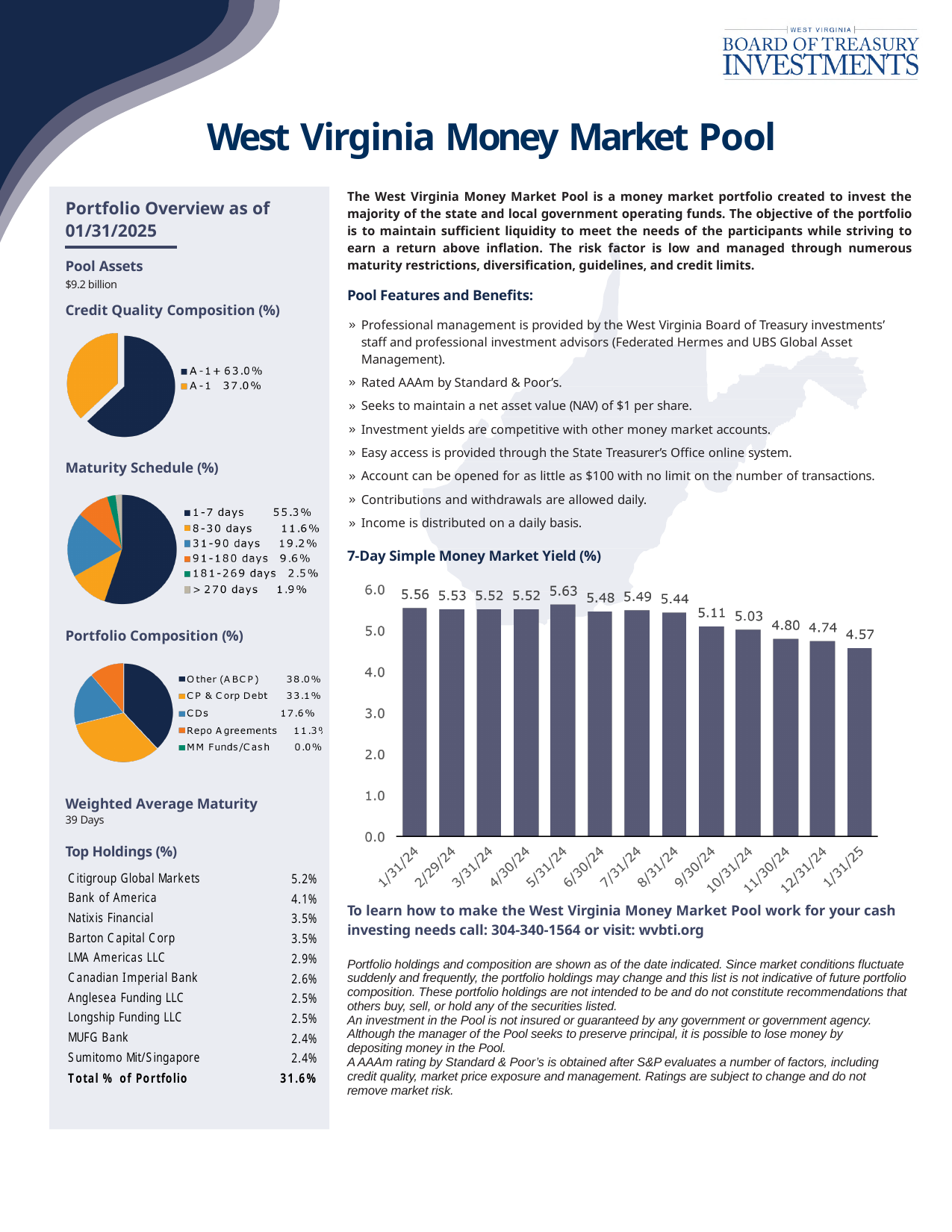
How many categories does the legend of the Portfolio Composition pie chart list? 5 In the Portfolio Composition pie chart, which is larger, CDs or Repo Agreements? CDs In the 7-Day Simple Money Market Yield chart, which date has the highest yield? 5/31/24 In the 7-Day Simple Money Market Yield chart, do the values generally rise or fall from 1/31/24 to 1/31/25? fall In the Maturity Schedule pie chart, what is the value for 31-90 days? 19.2% In the Maturity Schedule pie chart, which category has the largest share? 1-7 days In the 7-Day Simple Money Market Yield chart, how many dates are plotted? 13 In the 7-Day Simple Money Market Yield chart, which date has the lowest yield? 1/31/25 In the Credit Quality Composition pie chart, what share is A-1+? 63.0% In the 7-Day Simple Money Market Yield chart, what is the difference between the values for 1/31/24 and 1/31/25? 0.99 In the 7-Day Simple Money Market Yield chart, what is the value for 5/31/24? 5.63 What kind of chart is the 7-Day Simple Money Market Yield chart? bar chart